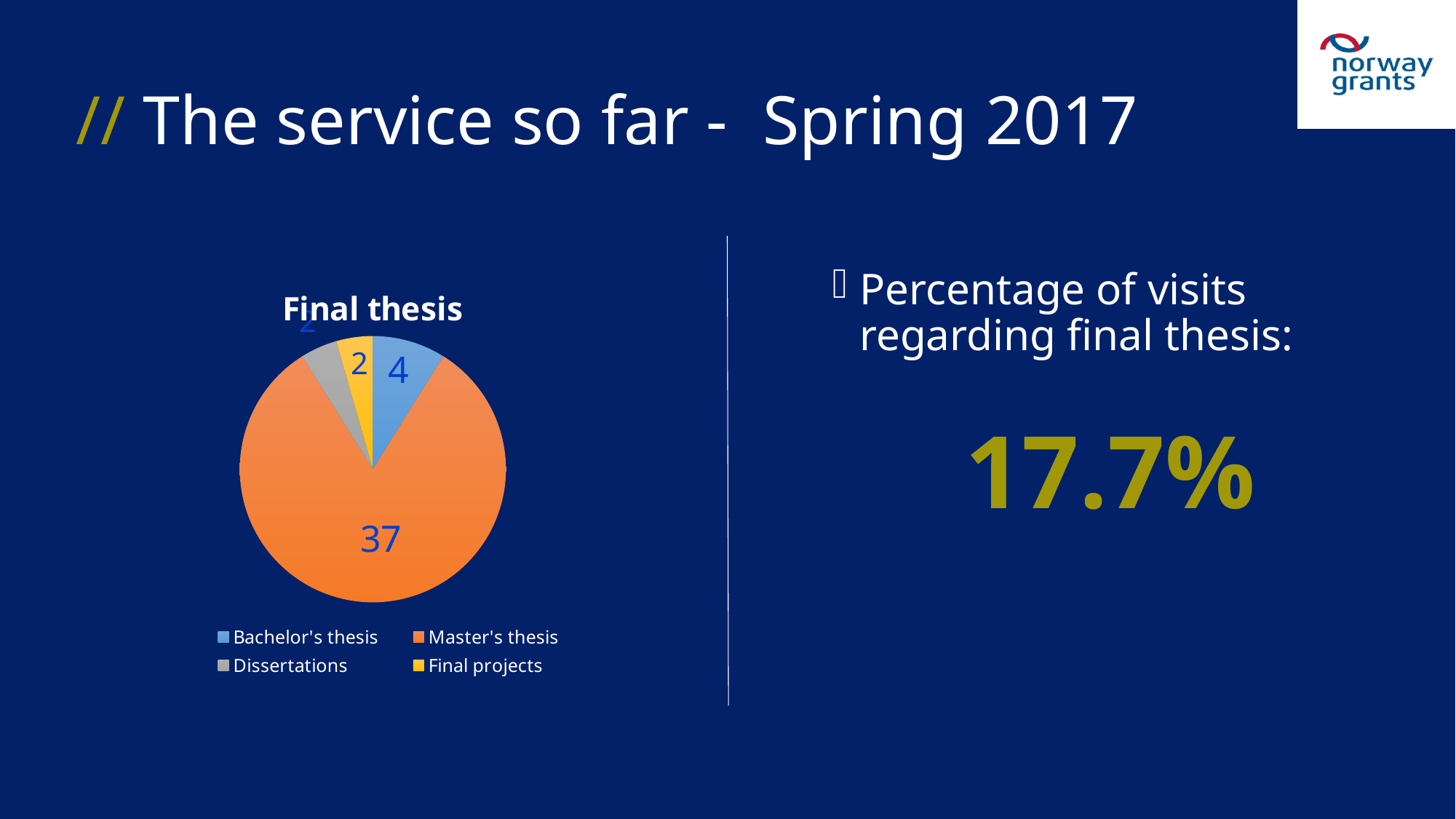
How many categories does the pie chart have? 4 What is the title of the chart? Final thesis What is the value for Final projects? 2 What is the value for Bachelor's thesis? 4 What is the difference between the values for Master's thesis and Bachelor's thesis? 33 What kind of chart is shown on the slide? pie chart What share of the pie does Master's thesis represent? 82.2% What is the value for Master's thesis? 37 What is the total of all slices in the pie chart? 45 Which colour represents Dissertations in the legend? grey Which is larger, Bachelor's thesis or Final projects? Bachelor's thesis Which category has the largest slice of the pie? Master's thesis